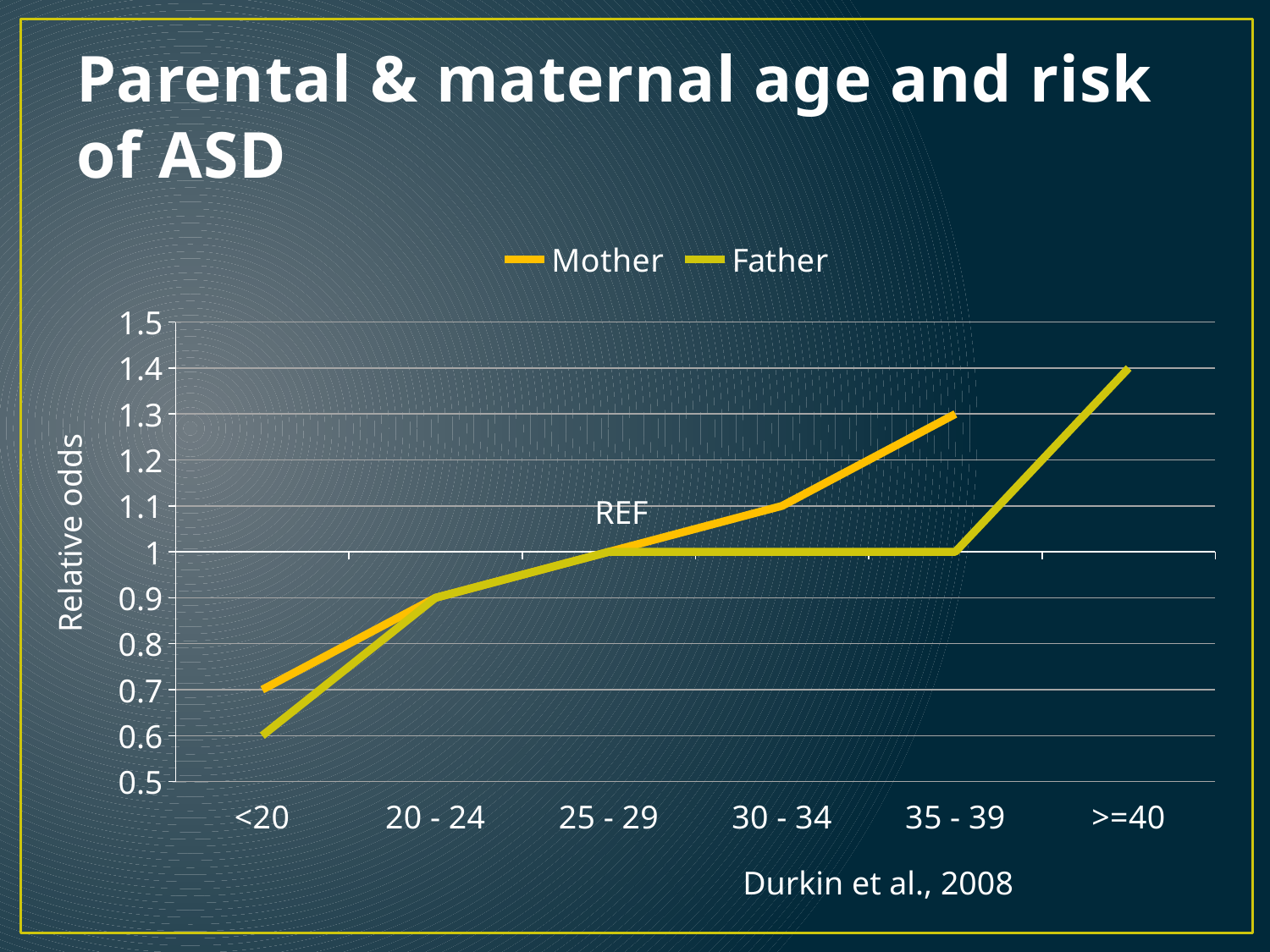
Do the relative odds for Father generally rise or fall as parental age increases along the x axis? Rise What is the relative odds for Father in the >=40 age group? 1.4 What is the relative odds for Mother in the <20 age group? 0.7 How many age categories are shown on the x axis? 6 Which age group has the lowest relative odds for Father? <20 Which age group is labelled REF on the chart? 25 - 29 How many series does the legend list? 2 What is the relative odds for Mother in the 35 - 39 age group? 1.3 What kind of chart is shown on the slide? Line chart In the <20 age group, which series has the higher relative odds, Mother or Father? Mother Which age group has the highest relative odds for Mother? 35 - 39 What is the relative odds for Father in the <20 age group? 0.6